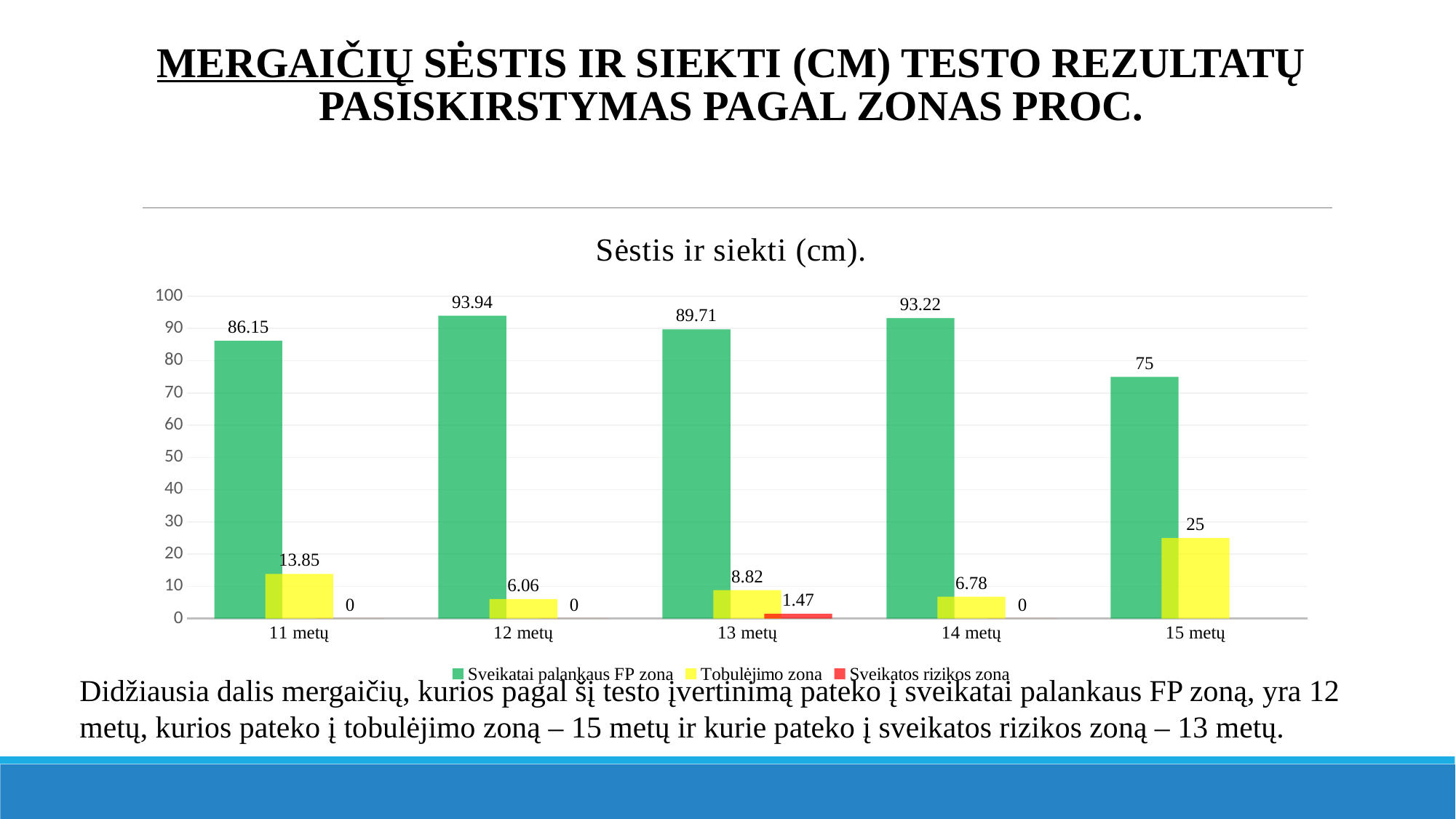
What is the value for 'Sveikatos rizikos zona' at 13 metų? 1.47 Which is larger: the 'Tobulėjimo zona' value for 13 metų or for 14 metų? 13 metų Which age group has the highest value for 'Tobulėjimo zona'? 15 metų What is the value for 'Sveikatai palankaus FP zona' at 12 metų? 93.94 What is the title of the chart? Sėstis ir siekti (cm). Which age group has the lowest value for 'Sveikatai palankaus FP zona'? 15 metų What kind of chart is shown on the slide? Bar chart How many series does the legend list? 3 What is the value for 'Tobulėjimo zona' at 11 metų? 13.85 Which age group has the highest value for 'Sveikatai palankaus FP zona'? 12 metų How many age groups are shown on the x axis? 5 What is the difference between the 'Sveikatai palankaus FP zona' values for 12 metų and 15 metų? 18.94